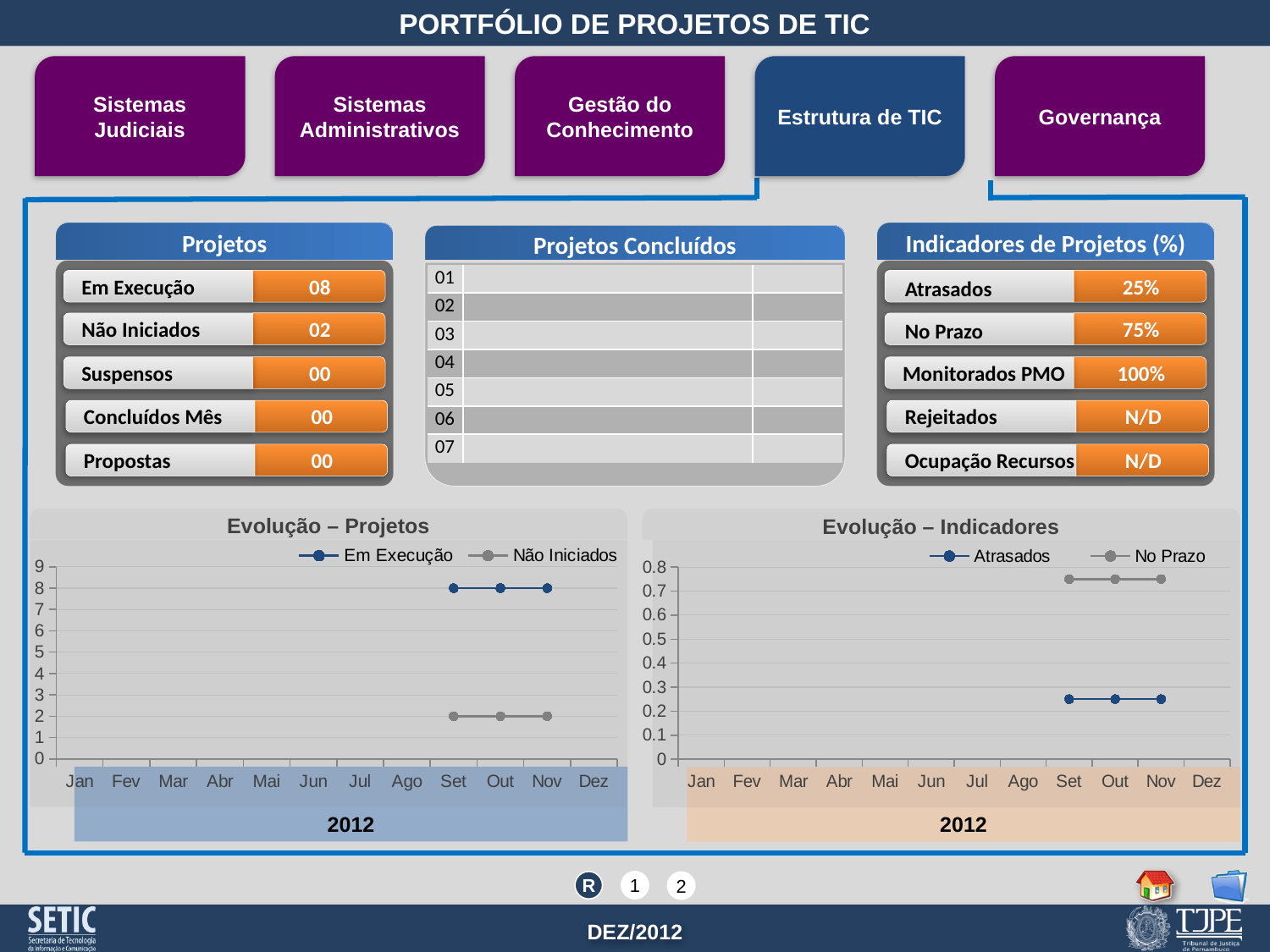
Which series are listed in the legend of the "Evolução – Indicadores" chart? Atrasados and No Prazo In the "Evolução – Projetos" chart, does the Em Execução series rise, fall or stay flat from Set to Nov? stays flat How many month categories are shown on the x axis of the "Evolução – Indicadores" chart? 12 In the "Evolução – Projetos" chart, what is the difference between Em Execução and Não Iniciados in Nov? 6 In the "Evolução – Projetos" chart, what is the value for Não Iniciados in Set? 2 In the "Evolução – Projetos" chart, which series is higher in Set, Em Execução or Não Iniciados? Em Execução In the "Evolução – Indicadores" chart, is the value for Atrasados in Nov greater or less than 0.5? less In the "Evolução – Projetos" chart, what is the value for Em Execução in Out? 8 What type of chart is "Evolução – Projetos"? line chart In the "Evolução – Indicadores" chart, which series is higher in Set, Atrasados or No Prazo? No Prazo In the "Evolução – Indicadores" chart, is the value for No Prazo in Out greater or less than 0.5? greater How many series does the legend of the "Evolução – Projetos" chart list? 2